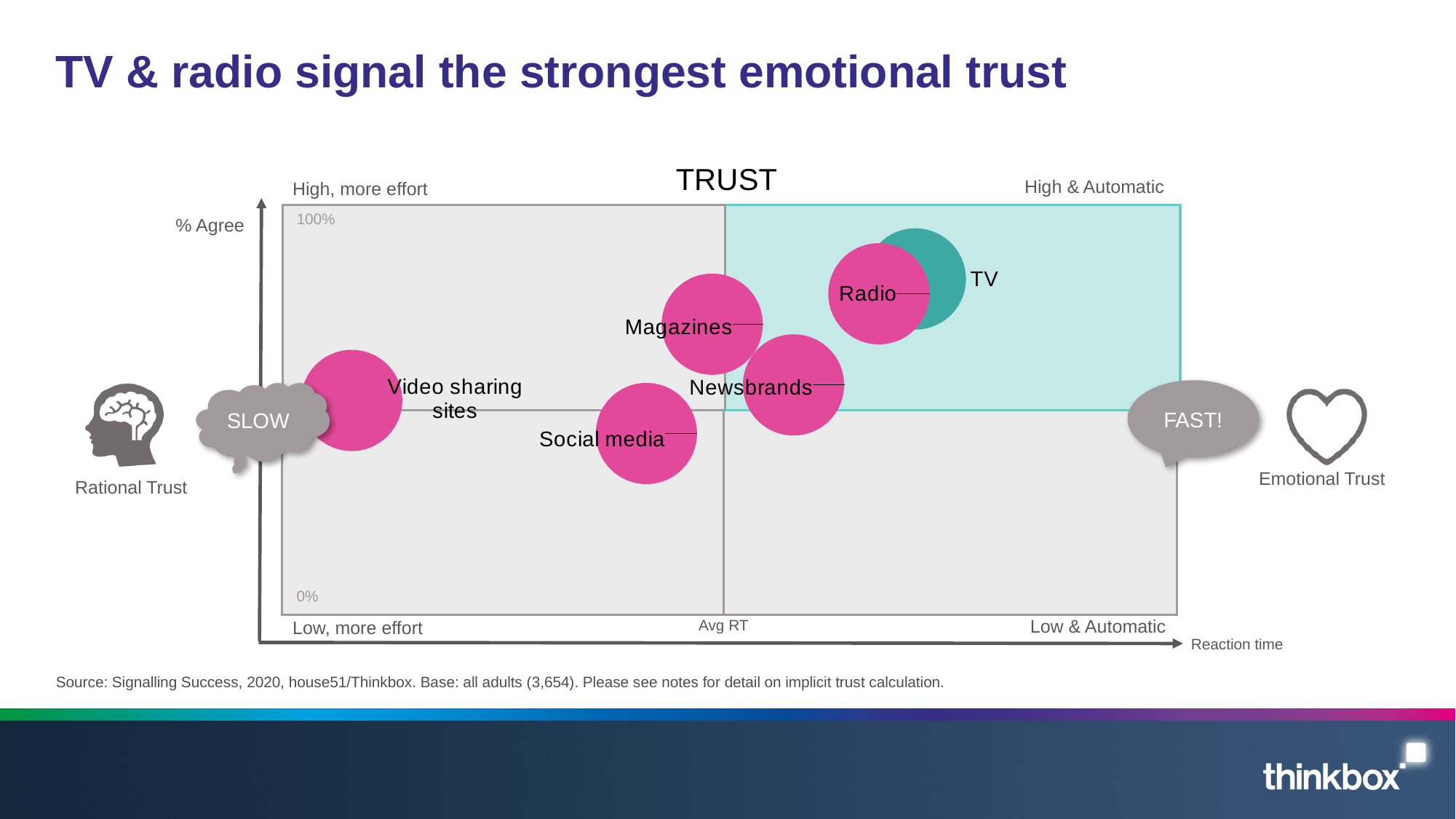
What kind of chart is shown on the slide? Bubble (scatter) chart What is the label of the horizontal axis of the chart? Reaction time Which has a higher % Agree, Radio or Video sharing sites? Radio How many media categories are plotted as bubbles on the chart? 6 Which has a faster reaction time (further right), Newsbrands or Social media? Newsbrands Which category has the lowest % Agree on the chart? Social media Which category is positioned furthest to the left (slowest reaction time) on the chart? Video sharing sites Which has a higher % Agree, Magazines or Social media? Magazines Which category is positioned furthest to the right (fastest reaction time) on the chart? TV What is the label of the vertical axis of the chart? % Agree